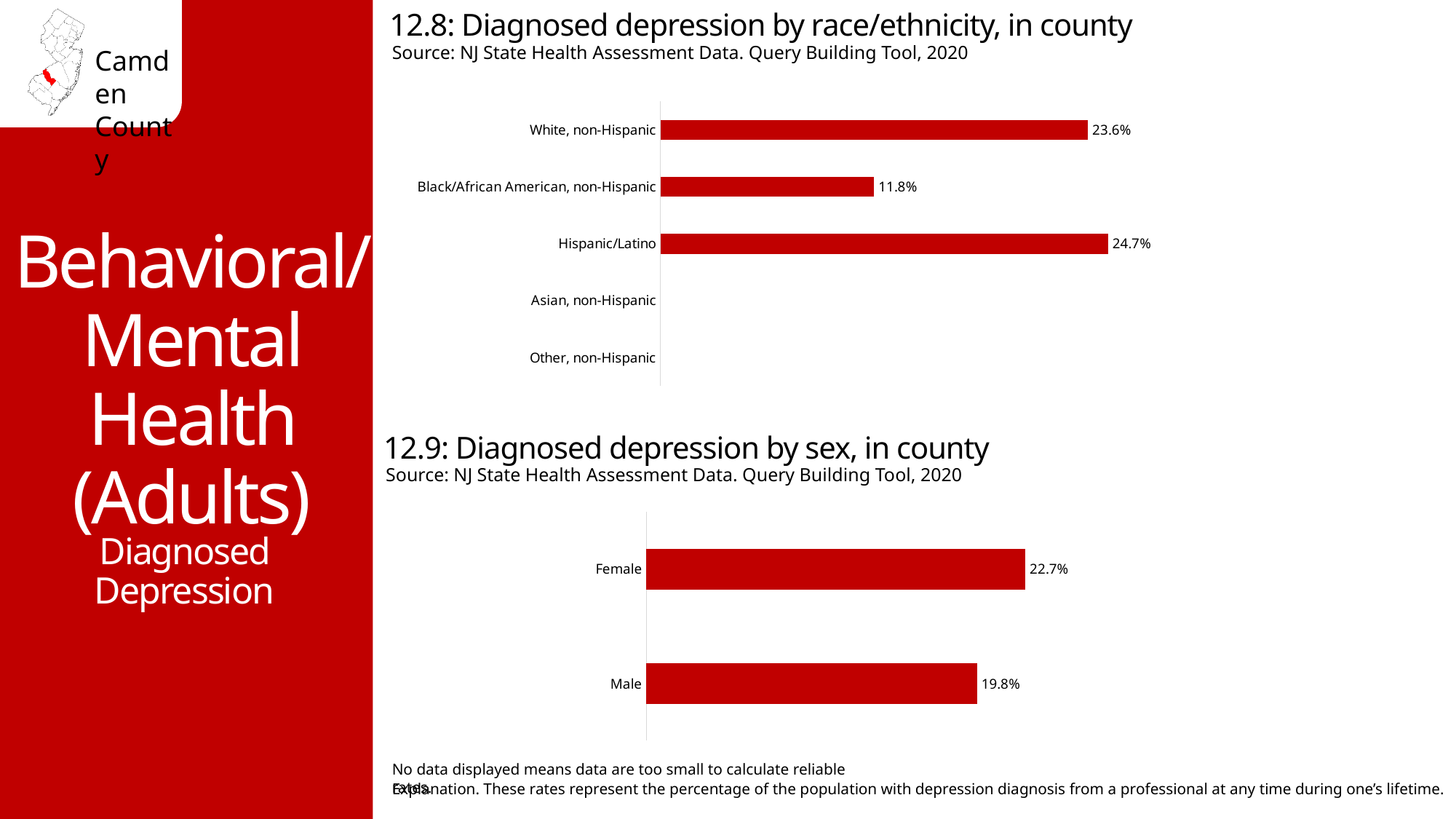
In the chart '12.8: Diagnosed depression by race/ethnicity, in county', which category with a plotted bar has the lowest value? Black/African American, non-Hispanic In the chart '12.9: Diagnosed depression by sex, in county', what is the value for Female? 22.7% In the chart '12.8: Diagnosed depression by race/ethnicity, in county', what is the difference between the values for White, non-Hispanic and Black/African American, non-Hispanic? 11.8% In the chart '12.9: Diagnosed depression by sex, in county', what is the value for Male? 19.8% What kind of chart is '12.9: Diagnosed depression by sex, in county'? Bar chart In the chart '12.8: Diagnosed depression by race/ethnicity, in county', what is the value for Black/African American, non-Hispanic? 11.8% In the chart '12.9: Diagnosed depression by sex, in county', what is the difference between the Female and Male values? 2.9% In the chart '12.8: Diagnosed depression by race/ethnicity, in county', how many categories are listed on the axis? 5 In the chart '12.8: Diagnosed depression by race/ethnicity, in county', what is the value for Hispanic/Latino? 24.7% In the chart '12.8: Diagnosed depression by race/ethnicity, in county', which categories have no bar displayed? Asian, non-Hispanic and Other, non-Hispanic In the chart '12.8: Diagnosed depression by race/ethnicity, in county', which category has the highest value? Hispanic/Latino In the chart '12.8: Diagnosed depression by race/ethnicity, in county', what is the value for White, non-Hispanic? 23.6%